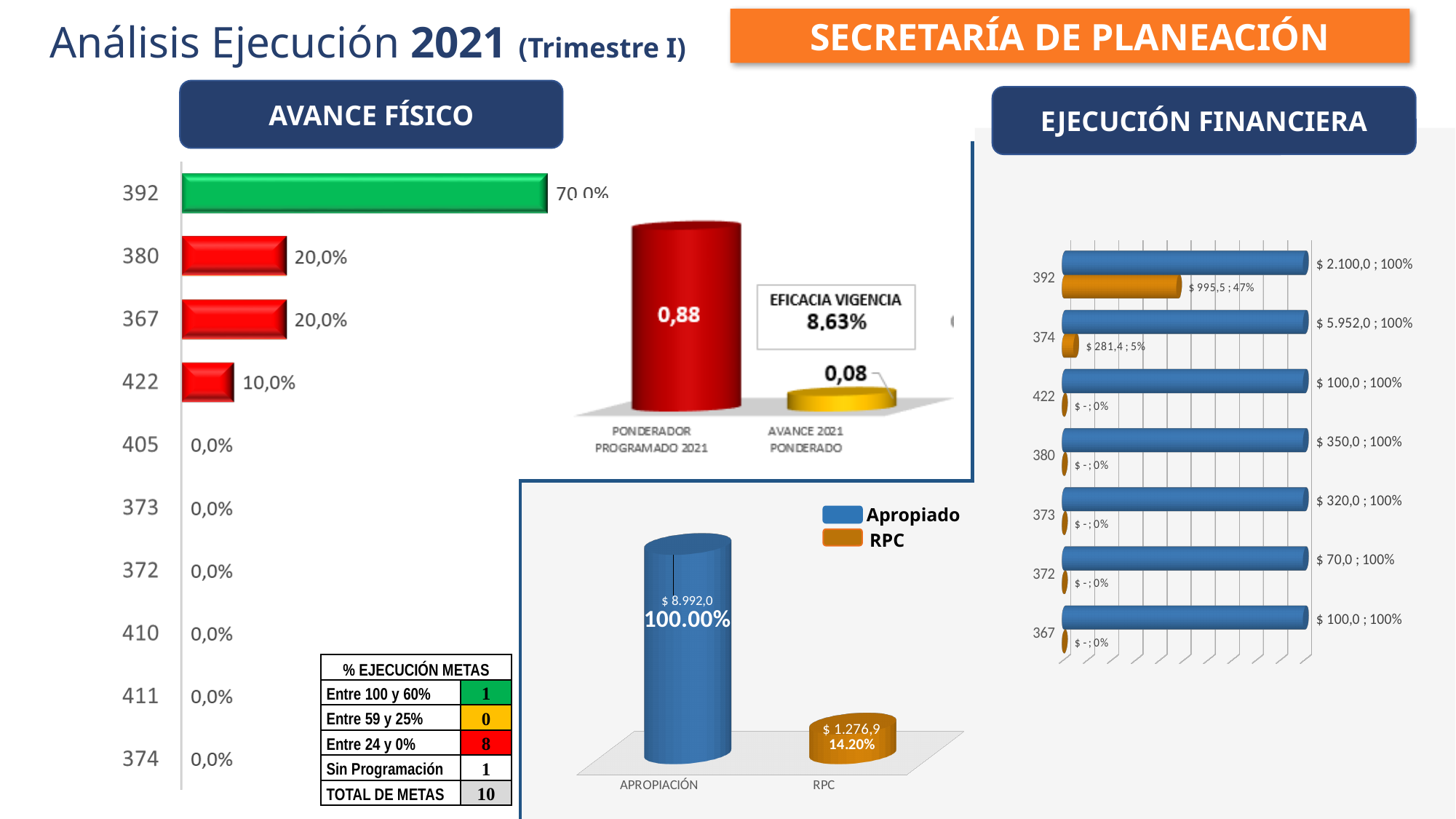
In the bottom-middle chart with APROPIACIÓN and RPC, what is the value for APROPIACIÓN? $ 8.992,0 In the AVANCE FÍSICO bar chart, what is the difference between the values for 392 and 380? 50,0% In the chart with PONDERADOR PROGRAMADO 2021 and AVANCE 2021 PONDERADO, what is the value for AVANCE 2021 PONDERADO? 0,08 How many categories are shown in the AVANCE FÍSICO bar chart? 10 In the chart with PONDERADOR PROGRAMADO 2021 and AVANCE 2021 PONDERADO, what is the value for PONDERADOR PROGRAMADO 2021? 0,88 How many series does the legend of the EJECUCIÓN FINANCIERA bar chart list? 2 In the EJECUCIÓN FINANCIERA bar chart, what is the RPC value for category 392? $ 995,5 In the EJECUCIÓN FINANCIERA bar chart, what is the Apropiado value for category 374? $ 5.952,0 In the AVANCE FÍSICO bar chart, what is the value for category 422? 10,0% In the AVANCE FÍSICO bar chart, which category has the highest value? 392 In the bottom-middle chart with APROPIACIÓN and RPC, what percentage is shown for RPC? 14.20% In the AVANCE FÍSICO bar chart, what is the value for category 392? 70,0%